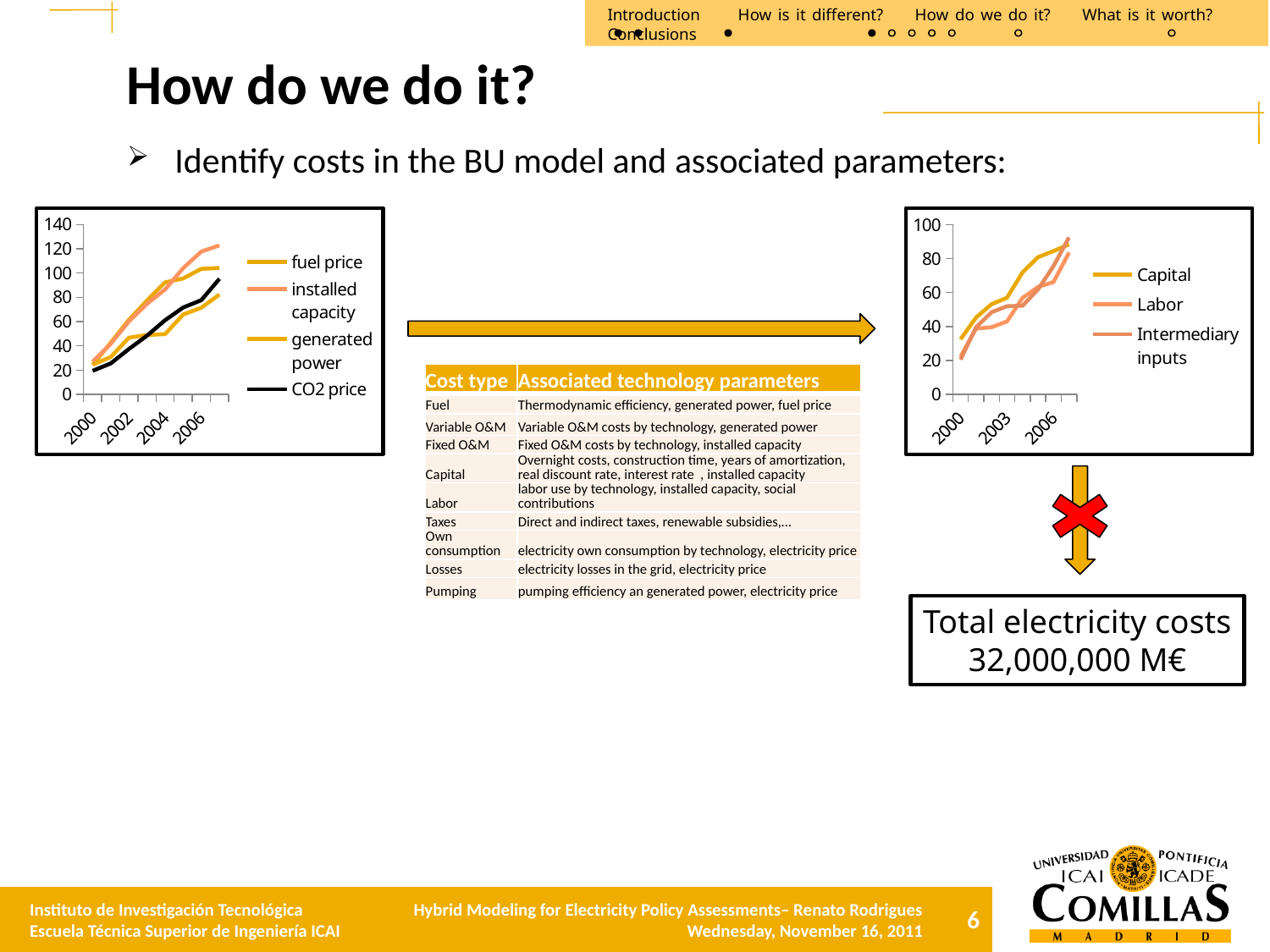
In the left chart, does the fuel price series rise or fall from 2000 to 2007? rise In the left chart, is the value for generated power in 2007 greater or less than 100? less How many series does the legend of the right chart list? 3 In the right chart, does the Capital series rise or fall from 2000 to 2007? rise In the left chart, is the value for installed capacity in 2007 greater or less than 100? greater In the right chart, is the value for Labor in 2007 greater or less than 80? greater What are the three series named in the legend of the right chart? Capital, Labor, Intermediary inputs What kind of chart is the chart on the left of the slide? line chart How many series does the legend of the left chart list? 4 Which series in the left chart is drawn in black? CO2 price